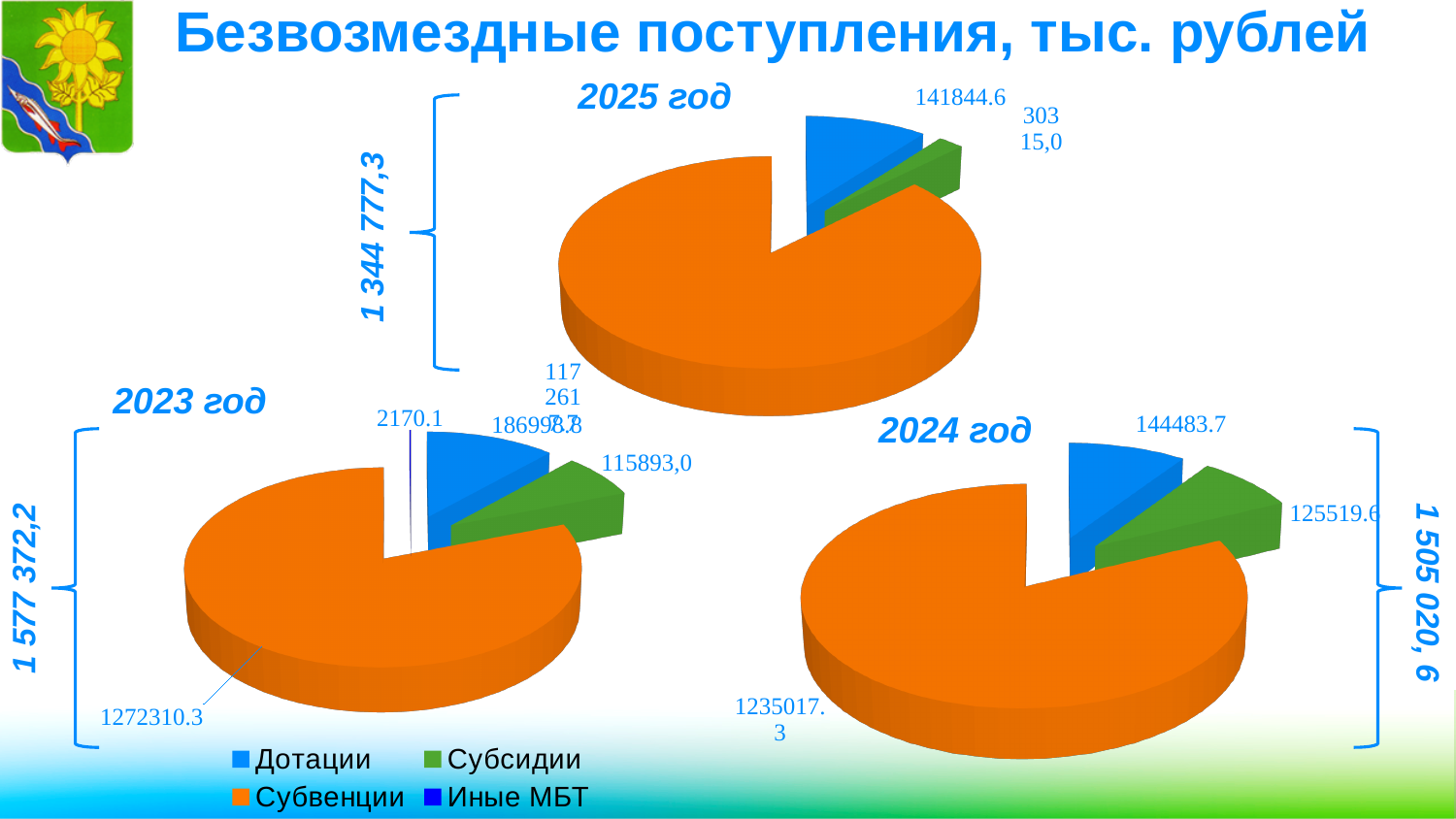
In the 2024 год chart, what is the value for Дотации? 144483.7 In the 2023 год chart, what is the value for Субвенции? 1272310.3 In the 2024 год chart, which category has the largest slice? Субвенции What kind of charts are shown on the slide? Pie charts In the 2024 год chart, what is the value for Субсидии? 125519.6 How many pie charts are on the slide? 3 How many series does the legend list? 4 In the 2024 год chart, which is larger, Дотации or Субсидии? Дотации In the 2023 год chart, what is the value for Иные МБТ? 2170.1 In the 2025 год chart, what is the value for Дотации? 141844.6 In the 2024 год chart, what is the difference between Дотации and Субсидии? 18964.1 In the 2024 год chart, what is the value for Субвенции? 1235017.3